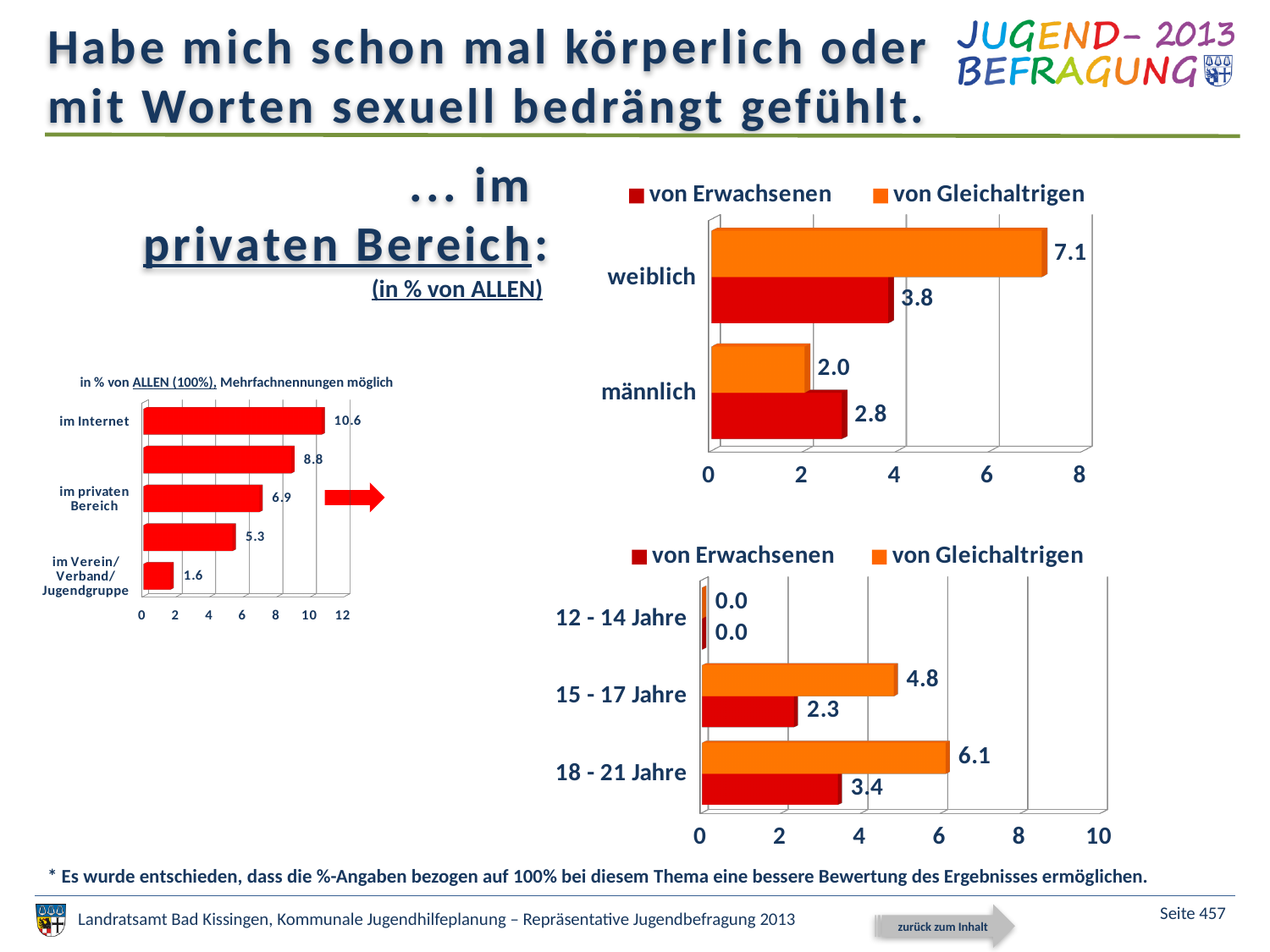
How many series does the legend of the top-right chart (by gender) list? 2 What kind of chart is the bottom-right chart (by age group)? bar chart In the bottom-right chart (by age group), how many age groups are shown? 3 In the bottom-right chart (by age group), what is the value for '15 - 17 Jahre' in the 'von Erwachsenen' series? 2.3 In the top-right chart (by gender), what is the value for 'männlich' in the 'von Erwachsenen' series? 2.8 In the small chart on the left, what is the highest value shown? 10.6 In the top-right chart (by gender), what is the value for 'weiblich' in the 'von Gleichaltrigen' series? 7.1 In the bottom-right chart (by age group), what is the value for '12 - 14 Jahre' in the 'von Erwachsenen' series? 0.0 In the bottom-right chart (by age group), what is the value for '18 - 21 Jahre' in the 'von Gleichaltrigen' series? 6.1 In the bottom-right chart (by age group), which age group has the highest 'von Gleichaltrigen' value? 18 - 21 Jahre In the top-right chart (by gender), which is larger for 'männlich': 'von Erwachsenen' or 'von Gleichaltrigen'? von Erwachsenen In the top-right chart (by gender), what is the difference between the 'von Gleichaltrigen' and 'von Erwachsenen' values for 'weiblich'? 3.3